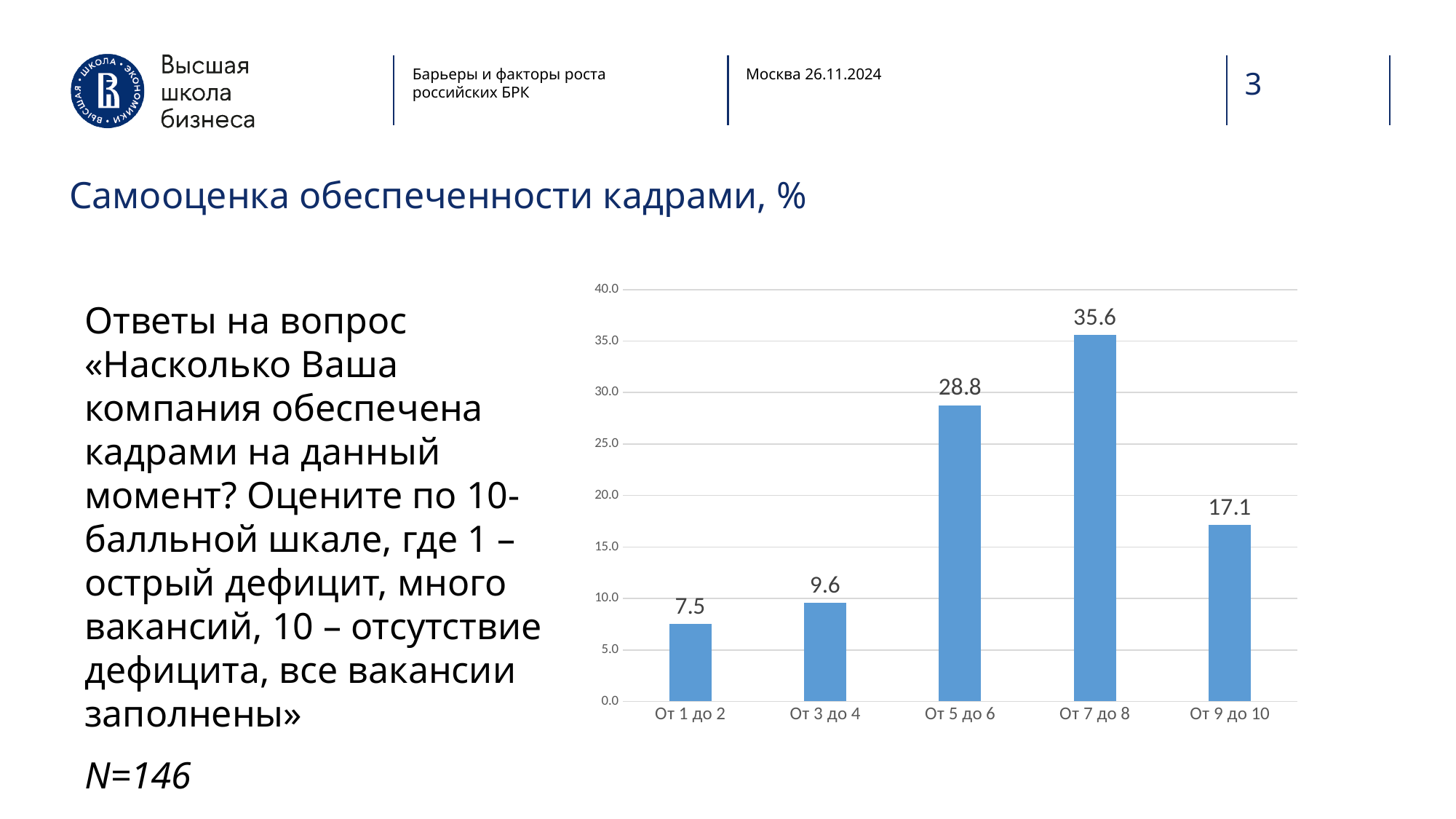
What is the value for the category "От 9 до 10"? 17.1 What is the value for the category "От 1 до 2"? 7.5 Which category has the lowest value? От 1 до 2 Is the value for "От 5 до 6" greater or less than 25.0? greater What kind of chart is shown on the slide? bar chart How many categories are shown on the x axis? 5 What is the value for the category "От 7 до 8"? 35.6 What is the difference between the values for "От 7 до 8" and "От 5 до 6"? 6.8 Which category has the highest value? От 7 до 8 What is the sample size (N) stated on the slide? N=146 What is the title of the slide above the chart? Самооценка обеспеченности кадрами, % Which is larger: the value for "От 3 до 4" or the value for "От 9 до 10"? От 9 до 10